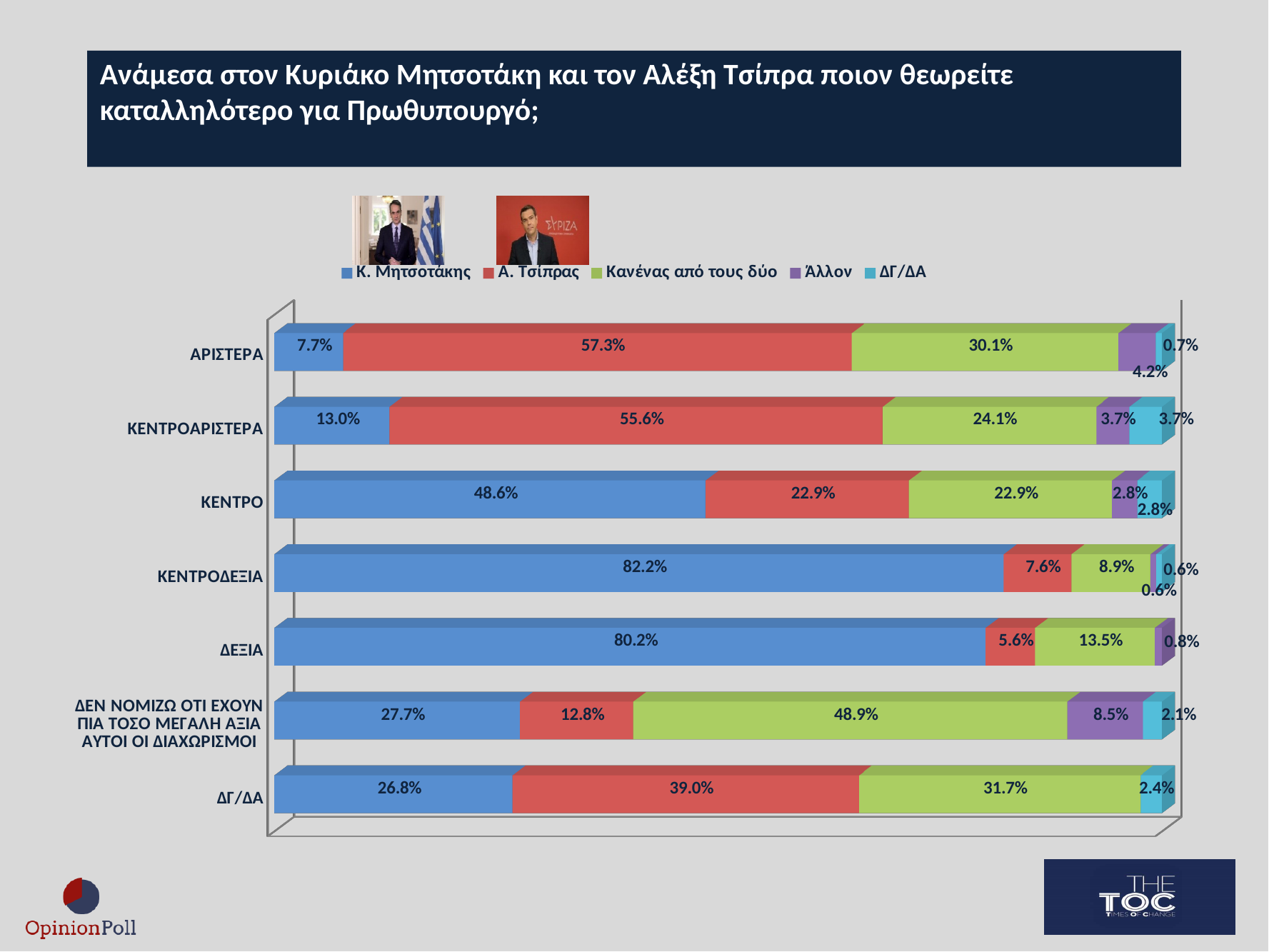
Which is larger: the Α. Τσίπρας value for ΔΓ/ΔΑ or the Κανένας από τους δύο value for ΔΓ/ΔΑ? Α. Τσίπρας (39.0%) How many series does the legend list? 5 What is the value for Κανένας από τους δύο in the ΔΕΝ ΝΟΜΙΖΩ ΟΤΙ ΕΧΟΥΝ ΠΙΑ ΤΟΣΟ ΜΕΓΑΛΗ ΑΞΙΑ ΑΥΤΟΙ ΟΙ ΔΙΑΧΩΡΙΣΜΟΙ category? 48.9% What is the difference between the Κ. Μητσοτάκης values for ΚΕΝΤΡΟΔΕΞΙΑ and ΔΕΞΙΑ? 2.0% Which series is shown in red in the legend? Α. Τσίπρας What kind of chart is shown on the slide? Stacked bar chart How many categories (bars) are shown on the chart? 7 What is the value for Άλλον in the ΚΕΝΤΡΟΑΡΙΣΤΕΡΑ category? 3.7% In which category does Κ. Μητσοτάκης have the highest value? ΚΕΝΤΡΟΔΕΞΙΑ In which category does Κ. Μητσοτάκης have the lowest value? ΑΡΙΣΤΕΡΑ What is the value for Α. Τσίπρας in the ΑΡΙΣΤΕΡΑ category? 57.3% What is the value for Κ. Μητσοτάκης in the ΚΕΝΤΡΟ category? 48.6%